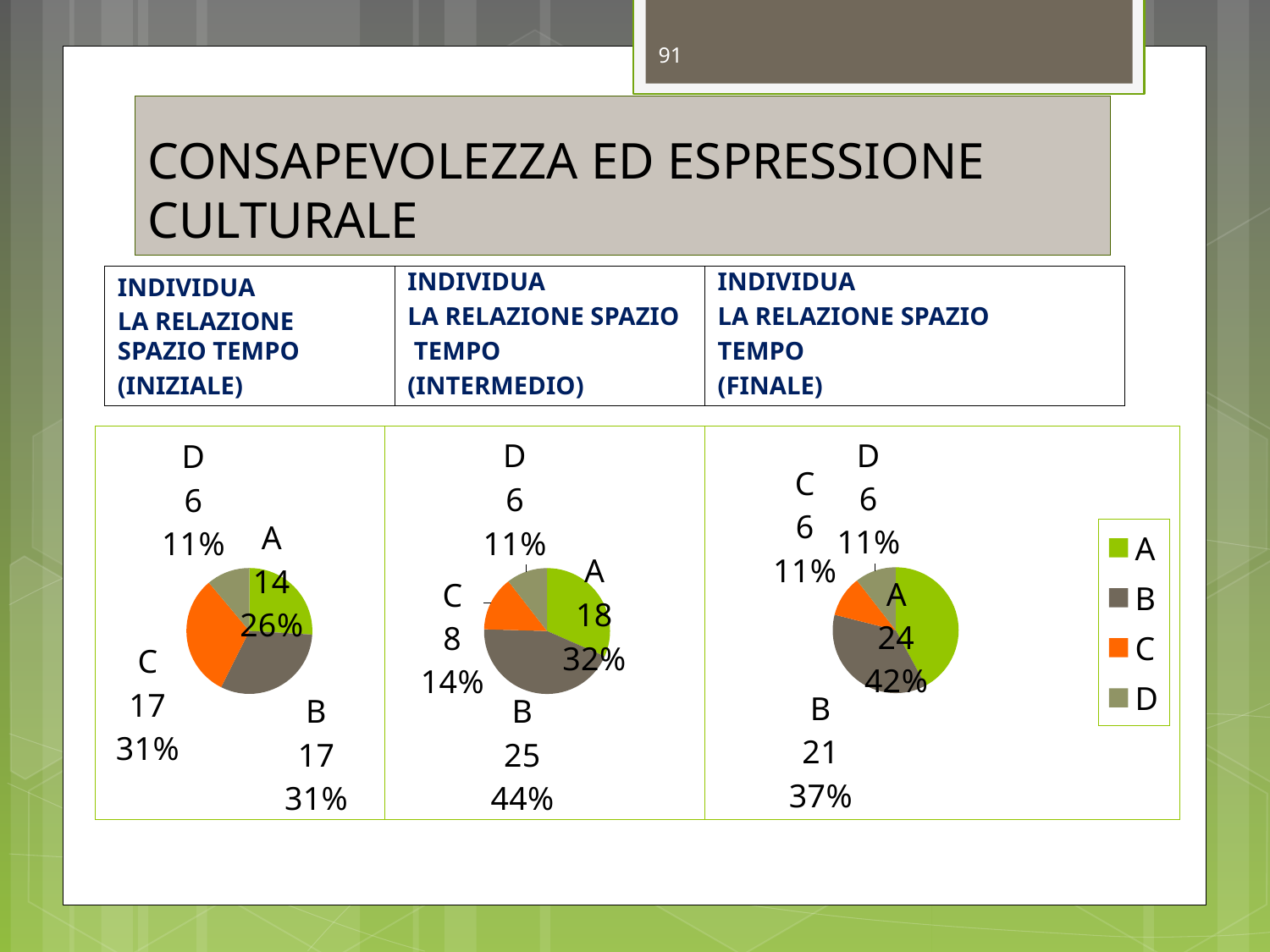
In the left pie chart (INIZIALE), what share of the pie does category C represent? 31% In the right pie chart (FINALE), what is the value for category A? 24 In the right pie chart (FINALE), what is the difference between the values for A and B? 3 In the left pie chart (INIZIALE), what is the value for category A? 14 In the middle pie chart (INTERMEDIO), what share of the pie does category C represent? 14% What kind of chart is used for the INTERMEDIO data? Pie chart In the middle pie chart (INTERMEDIO), which is larger, the value for A or the value for C? A How many slices does the left pie chart (INIZIALE) have? 4 In the middle pie chart (INTERMEDIO), which category has the largest slice? B How many entries does the legend on the slide list? 4 In the right pie chart (FINALE), which category has the largest slice? A In the middle pie chart (INTERMEDIO), what is the value for category B? 25